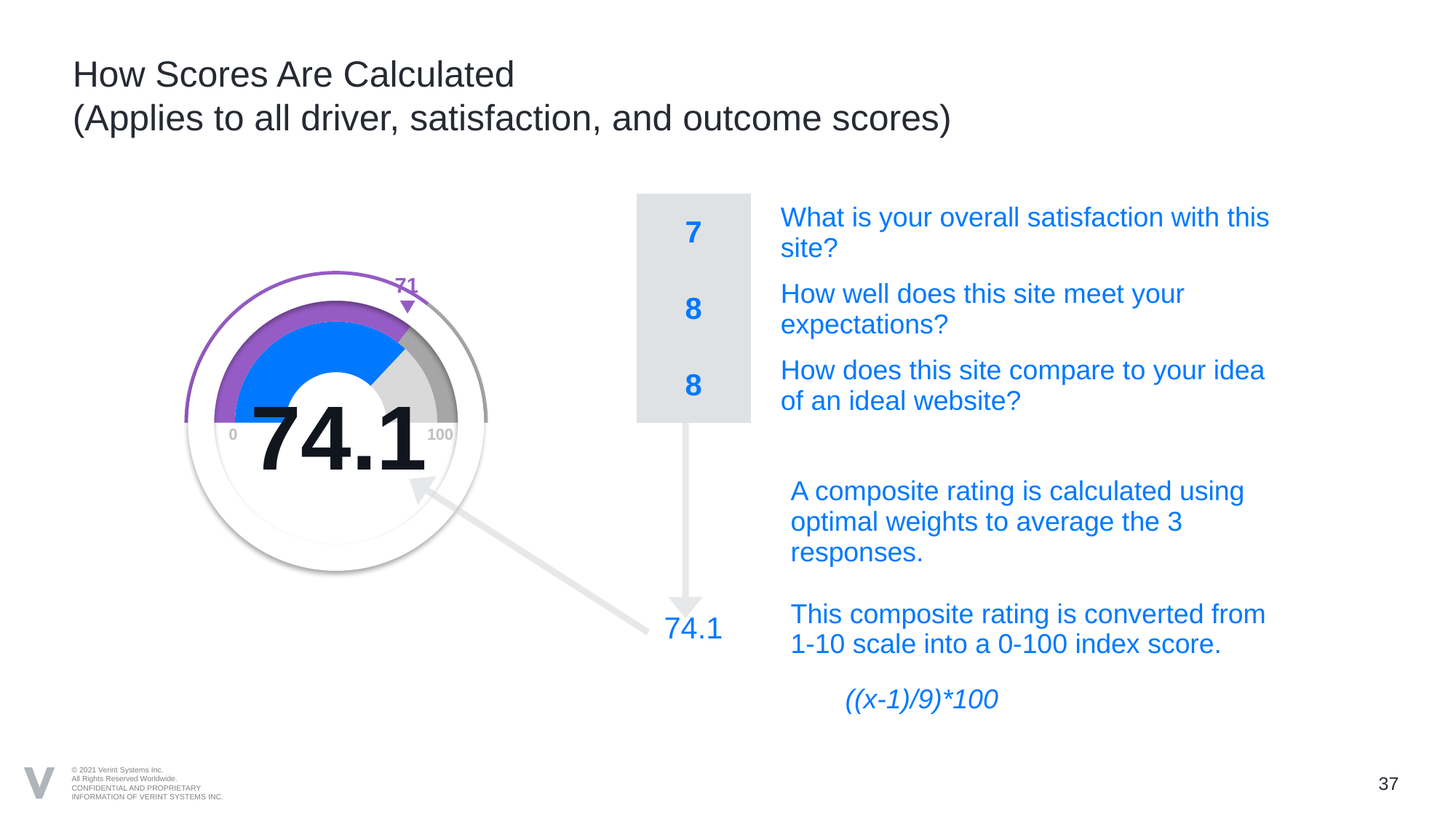
What value does the purple marker on the gauge chart indicate? 71 What colour is the marker labelled 71 on the gauge chart? purple What is the minimum value shown on the gauge chart's scale? 0 Is the gauge's displayed score of 74.1 greater or less than the purple marker value of 71? greater What colour is the filled arc representing the score on the gauge chart? blue What is the difference between the gauge's displayed score and the purple marker value? 3.1 Is the value shown on the gauge greater or less than 100? less What is the maximum value shown on the gauge chart's scale? 100 What value is displayed in the centre of the gauge chart? 74.1 Is the value shown on the gauge greater or less than 0? greater What kind of chart is shown on the left of the slide? gauge chart